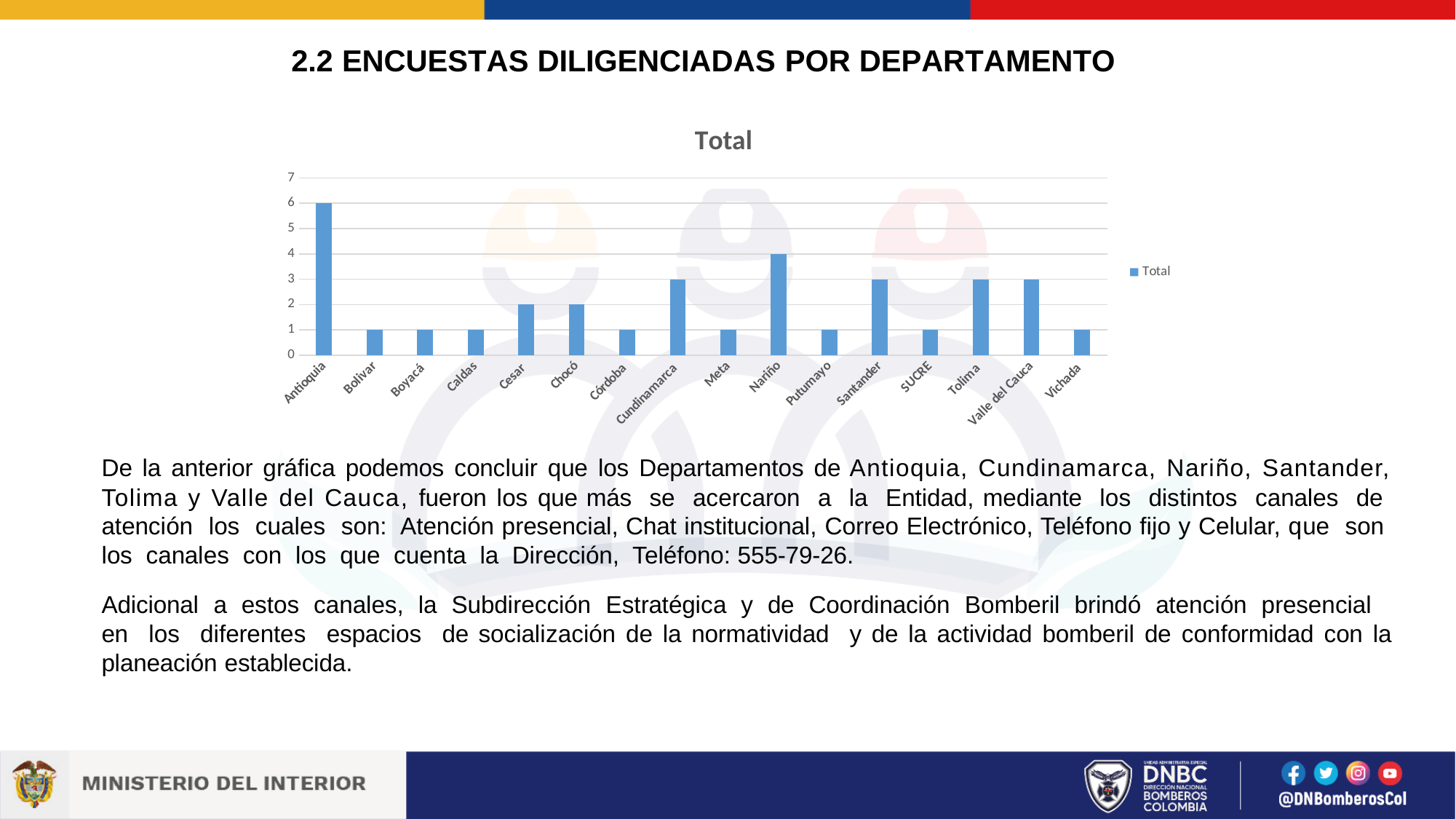
What is the value for Cesar? 2 How many series does the legend list? 1 Is the value for Antioquia greater or less than 5? greater What is the title of the chart? Total What is the value for Valle del Cauca? 3 What kind of chart is shown? bar chart Which is larger, the value for Cundinamarca or the value for Chocó? Cundinamarca What is the difference between the values for Antioquia and Nariño? 2 How many departments are shown on the x axis? 16 What is the value for Nariño? 4 What is the value for Antioquia? 6 Which department has the highest value? Antioquia